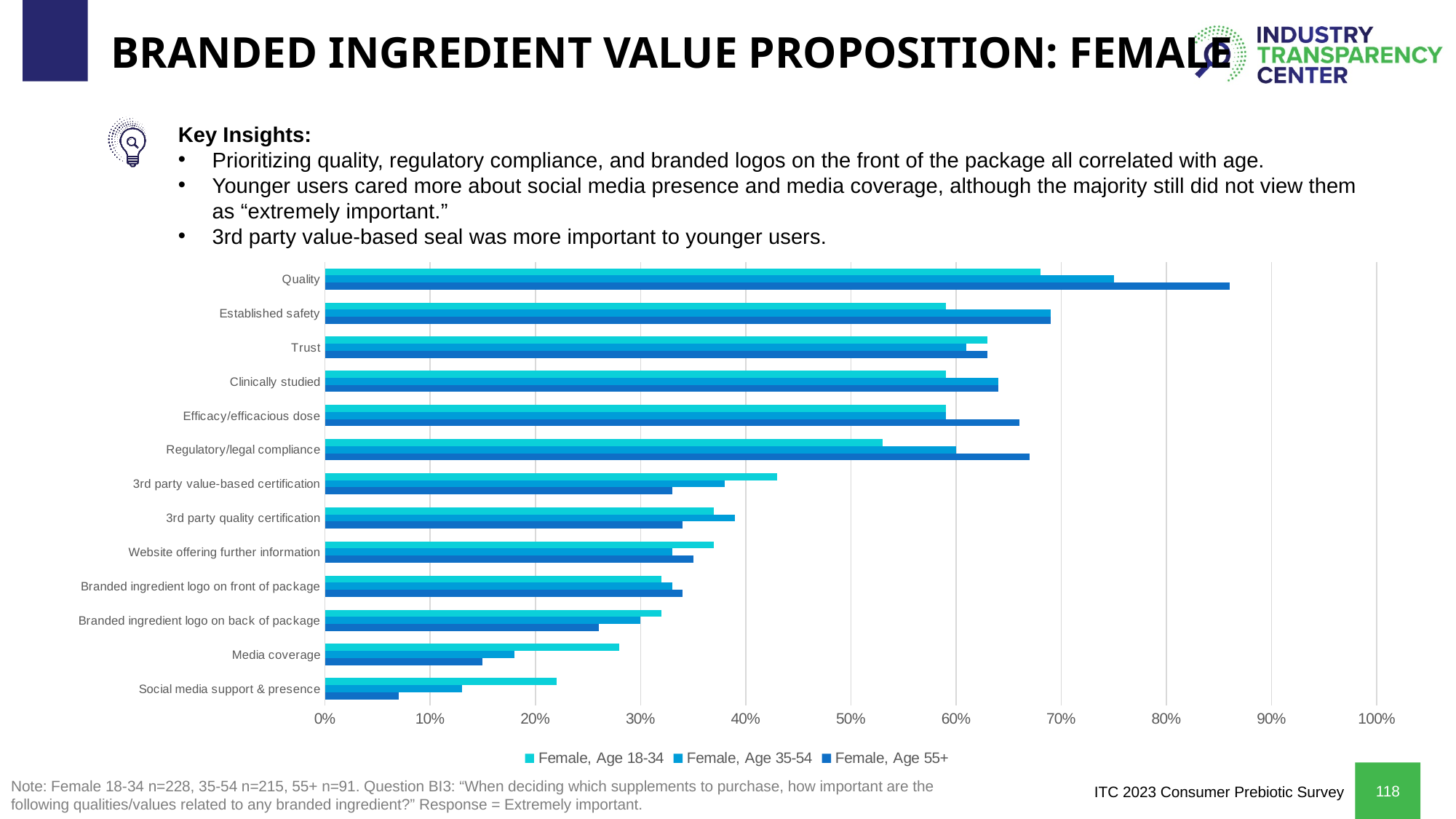
Which category has the lowest value for Female, Age 18-34? Social media support & presence How many series does the chart's legend list? 3 Is the value for Media coverage among Female, Age 18-34 greater or less than 30%? less For Quality, which group has the larger value: Female, Age 18-34 or Female, Age 55+? Female, Age 55+ Is the value for Regulatory/legal compliance among Female, Age 18-34 greater or less than 50%? greater What kind of chart is shown on the slide? bar chart Which category has the highest value for Female, Age 55+? Quality How many categories are plotted on the chart? 13 For 3rd party value-based certification, which group has the larger value: Female, Age 18-34 or Female, Age 55+? Female, Age 18-34 Is the value for Social media support & presence among Female, Age 55+ greater or less than 10%? less Which series is listed first in the chart's legend? Female, Age 18-34